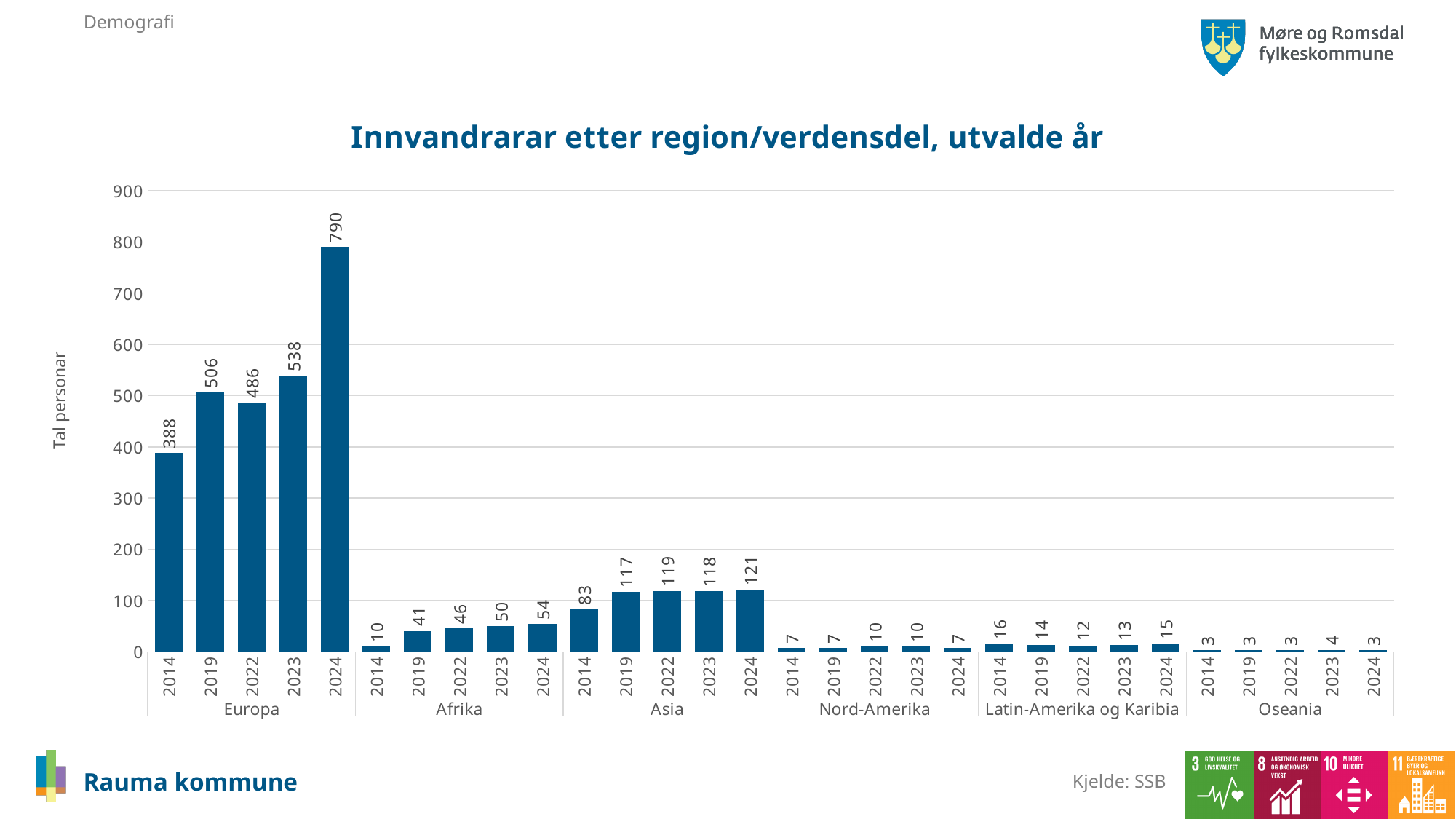
Which region and year has the highest bar? Europa 2024 Which is larger: Afrika in 2024 or Asia in 2014? Asia in 2014 What is the value for Afrika in 2019? 41 What is the label on the vertical axis? Tal personar Is the value for Europa in 2014 greater or less than 300? greater What is the title of the chart? Innvandrarar etter region/verdensdel, utvalde år What is the value for Asia in 2014? 83 What kind of chart is shown? Bar chart What is the value for Europa in 2024? 790 What is the difference between the Europa values for 2024 and 2023? 252 Do the values for Afrika rise or fall from 2014 to 2024? Rise How many bars are plotted in the chart? 30